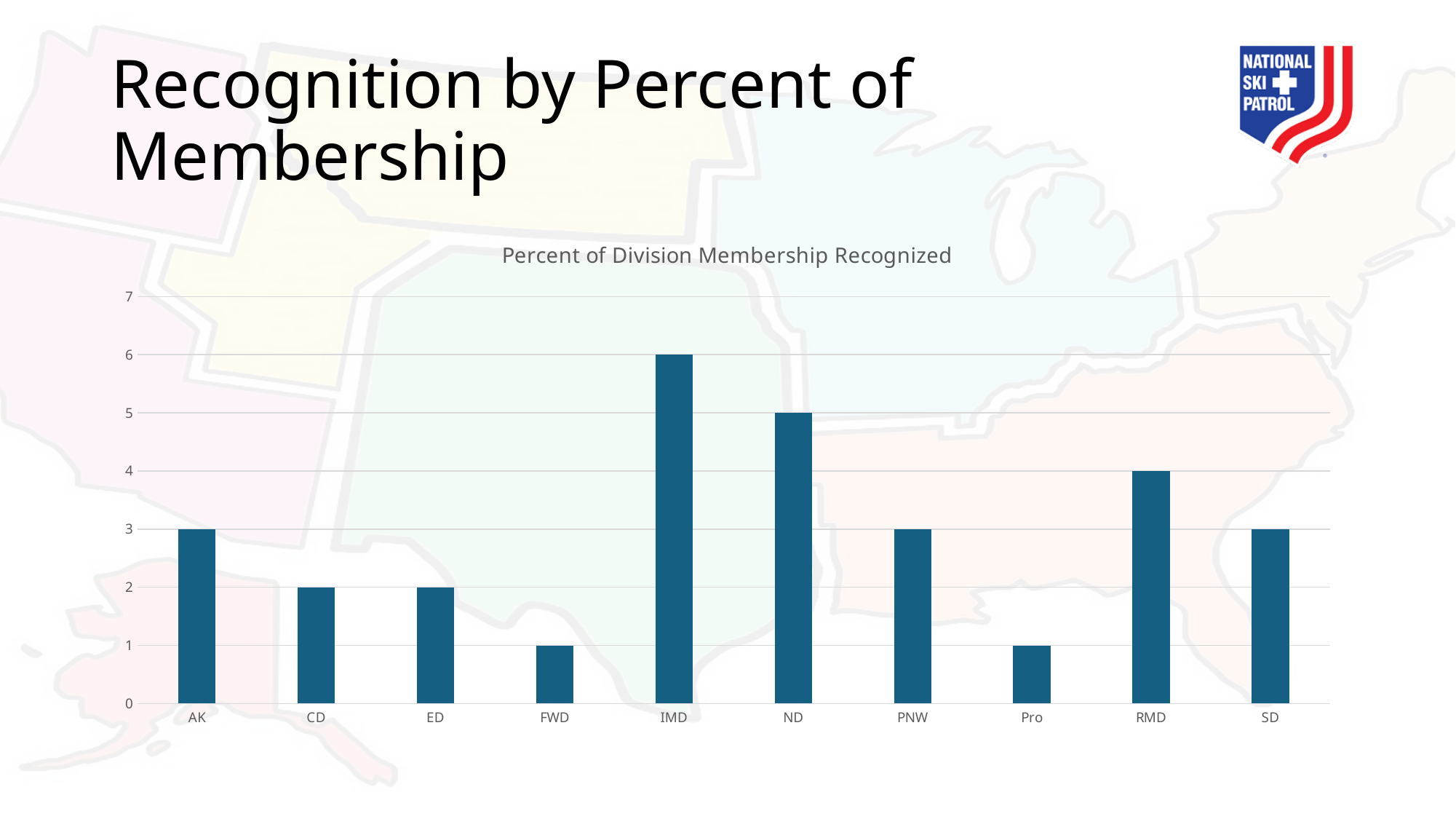
What is the title of the chart on the slide? Percent of Division Membership Recognized What is the value for IMD in the Percent of Division Membership Recognized chart? 6 Which is larger, the value for ND or the value for PNW? ND How many divisions are shown on the x axis of the chart? 10 Is the value for IMD greater or less than 5? greater What kind of chart is shown on the slide? Bar chart What is the difference between the values for RMD and FWD? 3 Which division has the highest percent of membership recognized? IMD What is the value for ND in the chart? 5 What is the value for RMD in the chart? 4 Which divisions share the lowest value in the chart? FWD and Pro What is the difference between the values for IMD and ND? 1